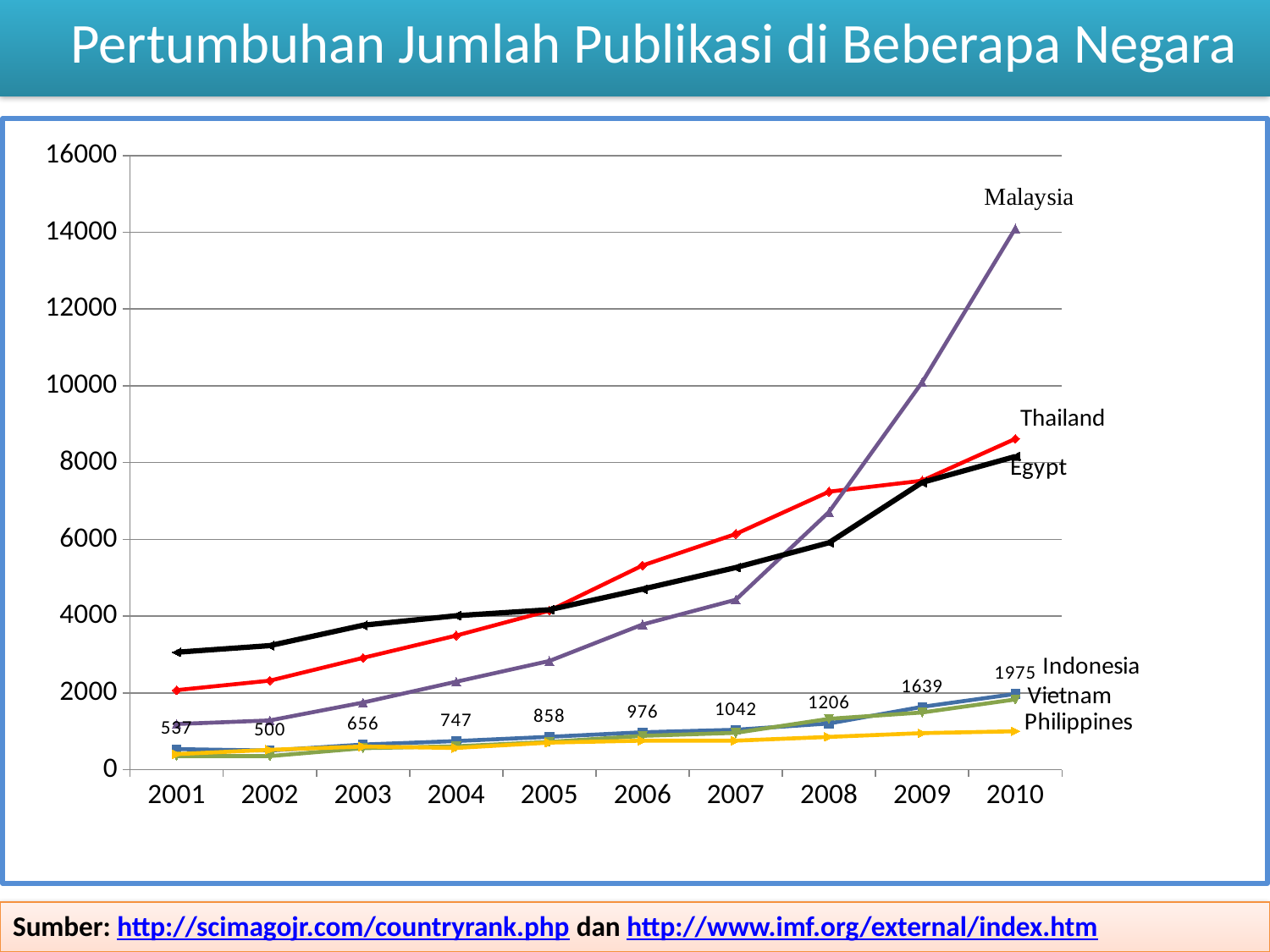
Which country has the highest number of publications in 2010? Malaysia Is the value for Malaysia in 2010 greater or less than 12000? greater Which country had more publications in 2008, Thailand or Egypt? Thailand What is the labelled value for Indonesia in 2010? 1975 What is the labelled value for Indonesia in 2008? 1206 What is the title of the slide? Pertumbuhan Jumlah Publikasi di Beberapa Negara What kind of chart is shown on the slide? line chart By how much did the labelled Indonesia value increase from 2009 to 2010? 336 Which country has the lowest number of publications in 2010? Philippines How many years are shown on the x axis? 10 How many countries are plotted as lines on the chart? 6 What is the labelled value for Indonesia in 2009? 1639